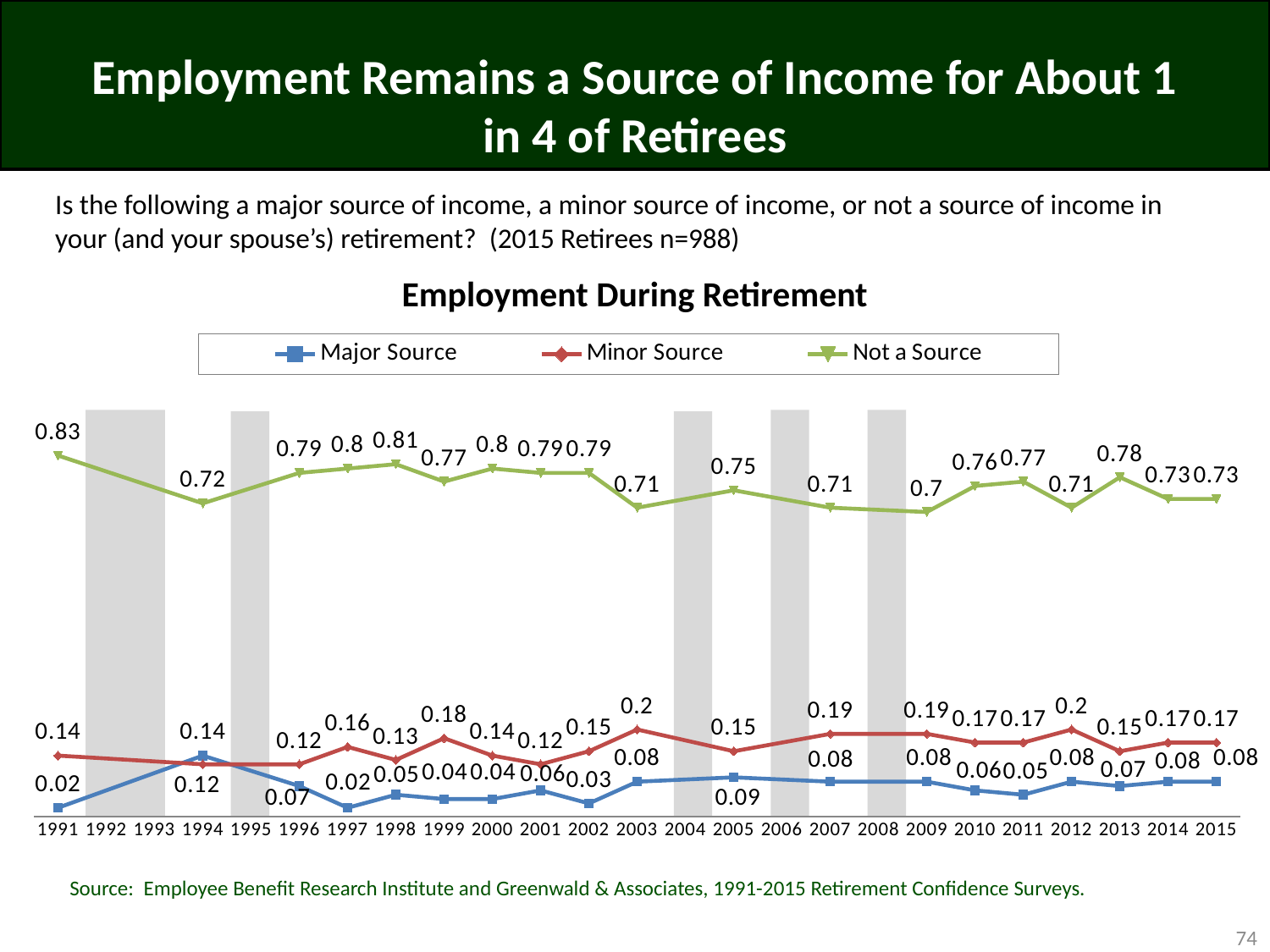
What kind of chart is "Employment During Retirement"? line chart In which year is the Not a Source value lowest? 2009 How many series does the legend of the "Employment During Retirement" chart list? 3 In 2015, which is larger: Minor Source or Major Source? Minor Source In which year is the Not a Source value highest? 1991 What is the value for Not a Source in 2015? 0.73 What is the value for Major Source in 2005? 0.09 What is the value for Minor Source in 2003? 0.2 What is the title of the chart on the slide? Employment During Retirement What is the value for Major Source in 1994? 0.14 Does the Not a Source value rise or fall from 1991 to 1994? fall What is the difference between the Not a Source value in 1991 and in 2015? 0.1